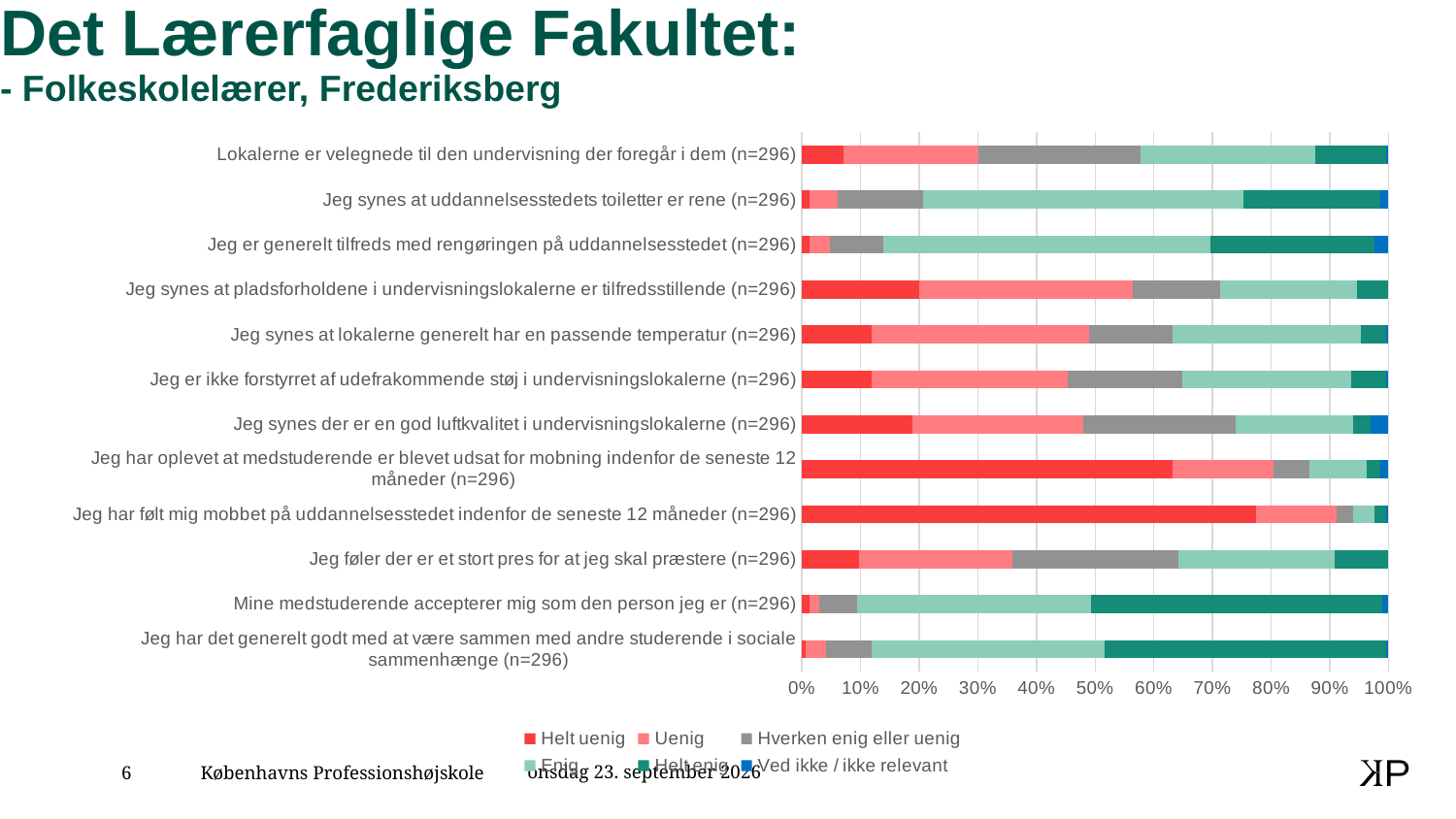
Which legend entry is shown in blue? Ved ikke / ikke relevant What kind of chart is shown on the slide? Stacked bar chart What is the subtitle of the slide below 'Det Lærerfaglige Fakultet:'? - Folkeskolelærer, Frederiksberg Is the 'Helt uenig' share for 'Jeg har oplevet at medstuderende er blevet udsat for mobning indenfor de seneste 12 måneder' greater or less than 50%? greater Is the 'Helt uenig' share for 'Jeg har følt mig mobbet på uddannelsesstedet indenfor de seneste 12 måneder' greater or less than 70%? greater Is the 'Helt enig' share for 'Mine medstuderende accepterer mig som den person jeg er' greater or less than 40%? greater What sample size (n) is shown for each statement in the chart? 296 Which statement has the largest 'Helt uenig' segment? Jeg har følt mig mobbet på uddannelsesstedet indenfor de seneste 12 måneder (n=296) How many statements (categories) are plotted in the chart? 12 Which has the larger 'Helt uenig' share: 'Jeg synes at pladsforholdene i undervisningslokalerne er tilfredsstillende' or 'Jeg føler der er et stort pres for at jeg skal præstere'? Jeg synes at pladsforholdene i undervisningslokalerne er tilfredsstillende How many series does the legend list? 6